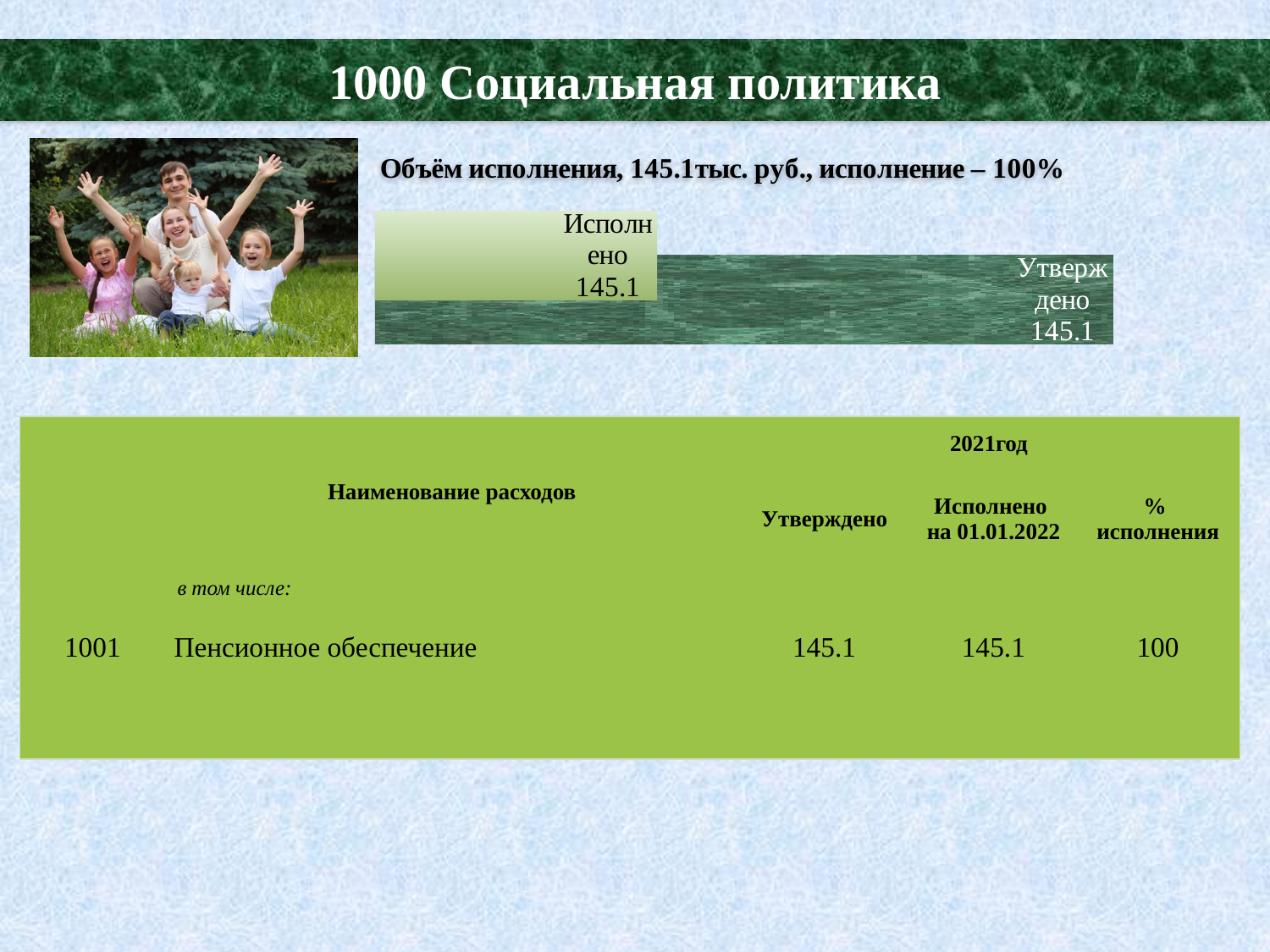
What kind of chart is shown on the slide? bar chart What are the two labels shown on the bars of the chart? Исполнено and Утверждено Are the values for Исполнено and Утверждено in the chart equal? Yes How many bars does the chart show? 2 Which bar in the chart is labelled with the value 145.1 on the left side? Исполнено What is the value of the bar labelled Исполнено? 145.1 What is the difference between the Утверждено and Исполнено values in the chart? 0 What is the value of the bar labelled Утверждено? 145.1